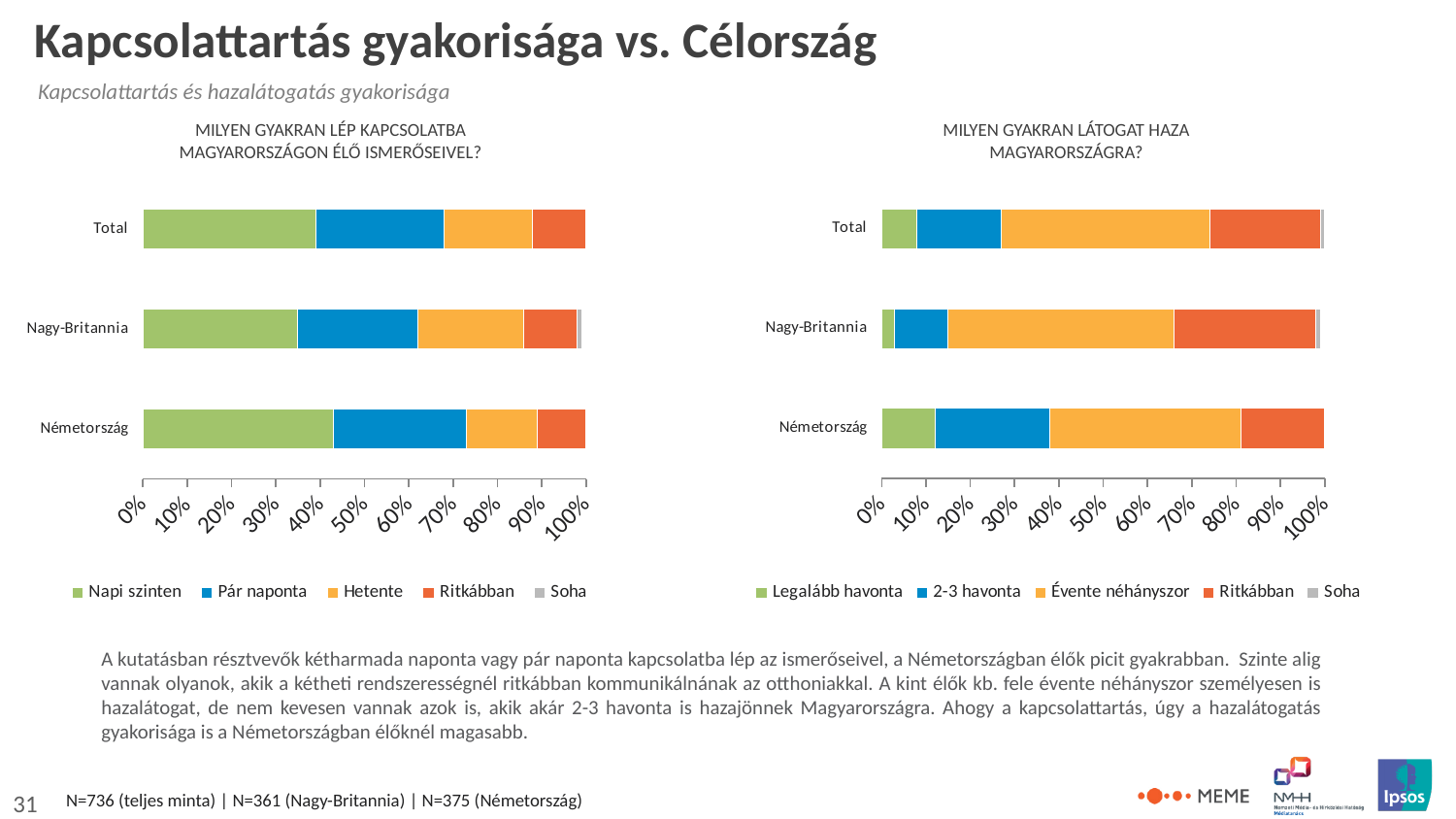
In the right chart, is the 'Legalább havonta' value for Németország greater or less than 20%? less In the left chart, is the 'Napi szinten' value for Németország greater or less than 30%? greater In the left chart, is the 'Napi szinten' value for Nagy-Britannia greater or less than 40%? less What is the first legend entry of the right chart? Legalább havonta In the left chart, which has the larger 'Napi szinten' share: Nagy-Britannia or Németország? Németország What is the title of the left chart? Milyen gyakran lép kapcsolatba Magyarországon élő ismerőseivel? In the right chart, which has the larger 'Legalább havonta' share: Nagy-Britannia or Németország? Németország How many series does the legend of the right chart, 'Milyen gyakran látogat haza Magyarországra?', list? 5 How many series does the legend of the left chart list? 5 How many categories (bars) does the left chart show? 3 What kind of chart is the left chart, 'Milyen gyakran lép kapcsolatba Magyarországon élő ismerőseivel?'? Stacked bar chart